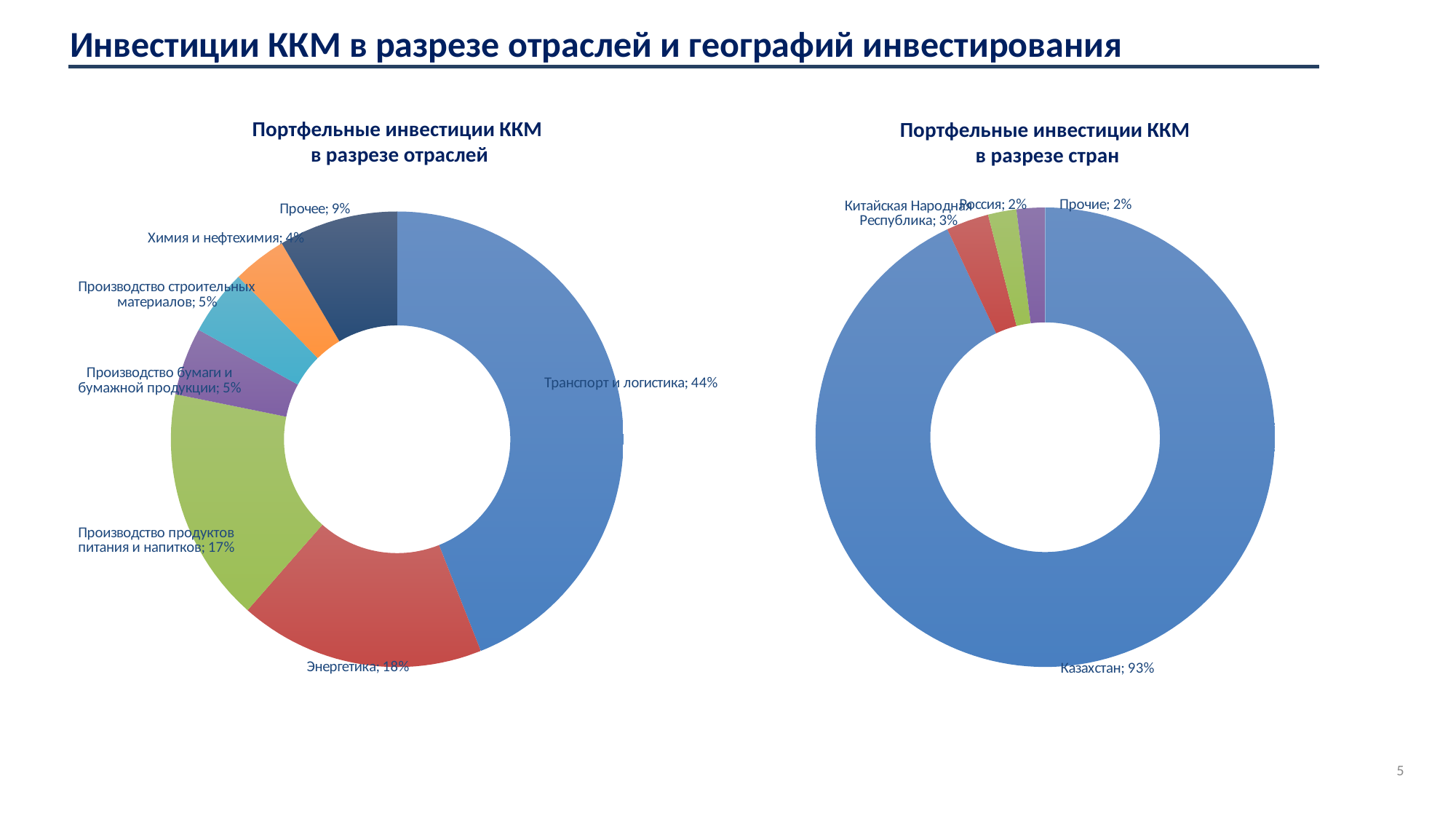
In the chart 'Портфельные инвестиции ККМ в разрезе отраслей', how many categories are shown? 7 In the chart 'Портфельные инвестиции ККМ в разрезе отраслей', what is the difference in percentage points between 'Транспорт и логистика' and 'Энергетика'? 26 In the chart 'Портфельные инвестиции ККМ в разрезе стран', how many categories are shown? 4 In the chart 'Портфельные инвестиции ККМ в разрезе отраслей', which category has the smallest share? Химия и нефтехимия In the chart 'Портфельные инвестиции ККМ в разрезе стран', what share does 'Китайская Народная Республика' have? 3% In the chart 'Портфельные инвестиции ККМ в разрезе отраслей', what share does 'Прочее' have? 9% In the chart 'Портфельные инвестиции ККМ в разрезе отраслей', which category has the largest share? Транспорт и логистика In the chart 'Портфельные инвестиции ККМ в разрезе стран', what share does 'Казахстан' have? 93% In the chart 'Портфельные инвестиции ККМ в разрезе стран', which is larger: 'Китайская Народная Республика' or 'Россия'? Китайская Народная Республика What type of chart is 'Портфельные инвестиции ККМ в разрезе стран'? Pie (doughnut) chart In the chart 'Портфельные инвестиции ККМ в разрезе отраслей', what share does 'Транспорт и логистика' have? 44% In the chart 'Портфельные инвестиции ККМ в разрезе отраслей', what share does 'Энергетика' have? 18%